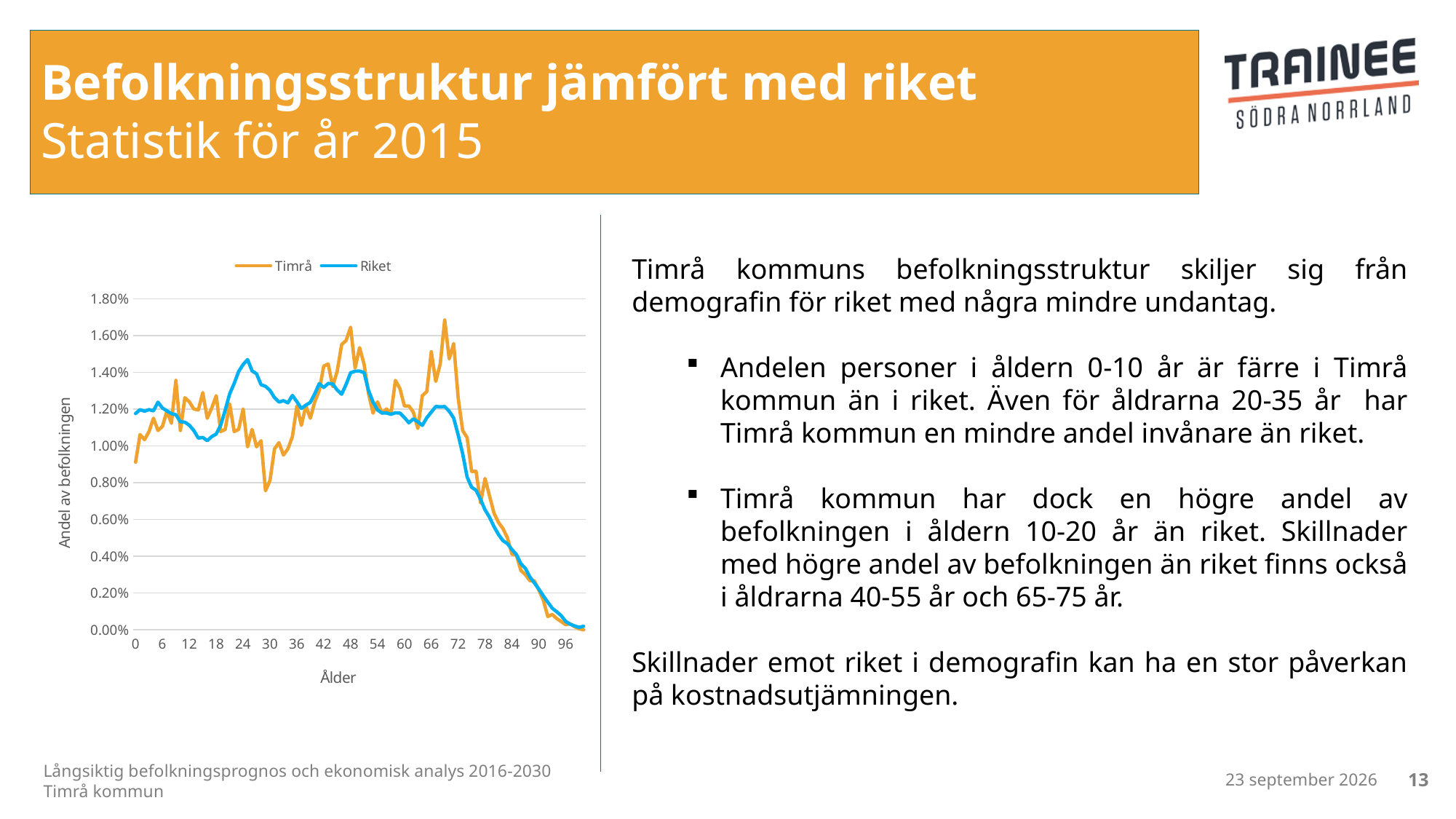
Is the value for Riket at age 0 greater or less than 1.00%? greater Is the value for Timrå at age 0 greater or less than 1.00%? less At age 0, which series has the higher value, Timrå or Riket? Riket At age 48, which series has the higher value, Timrå or Riket? Timrå Is the value for Timrå at age 48 greater or less than 1.40%? greater How many series does the chart's legend list? 2 What kind of chart is shown on the slide? line chart What is the title of the chart's x axis? Ålder Which series reaches the highest value anywhere on the chart? Timrå Do the values for Riket rise or fall between age 72 and age 96? fall What are the two series named in the chart's legend? Timrå and Riket